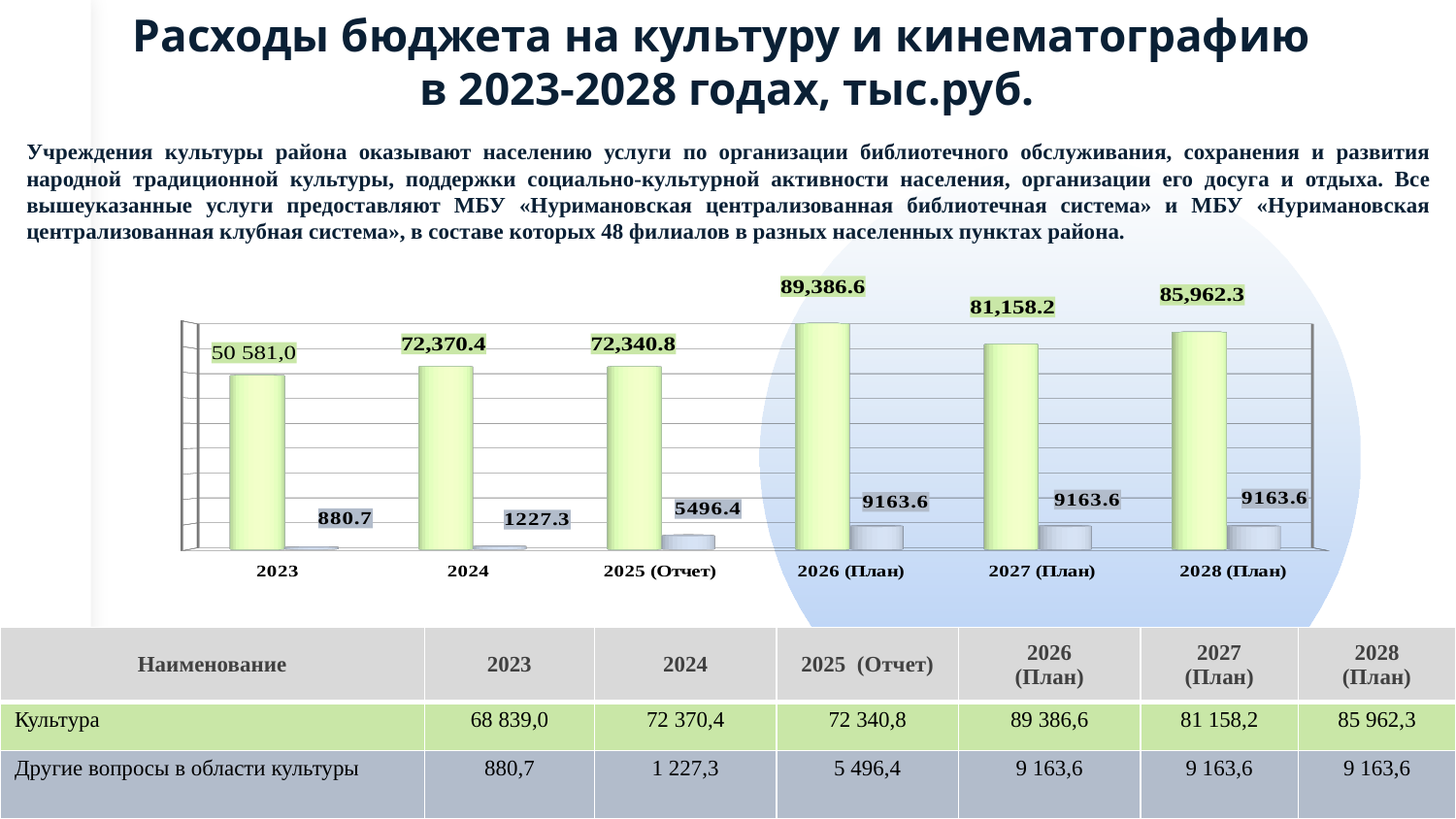
What unit of measurement is stated in the slide title for the chart values? тыс.руб. In which year is the small grey bar the lowest? 2023 Do the grey bar values rise or fall from 2023 to 2026 (План)? rise Which green bar is larger, 2027 (План) or 2028 (План)? 2028 (План) How many year categories are shown along the x axis of the chart? 6 What is the value of the tall green bar for 2026 (План)? 89,386.6 What kind of chart is shown on the slide? bar chart What is the difference between the green bar values for 2026 (План) and 2027 (План)? 8,228.4 What is the value of the small grey bar for 2025 (Отчет)? 5496.4 What is the difference between the grey bar values for 2025 (Отчет) and 2024? 4269.1 What is the value of the small grey bar for 2028 (План)? 9163.6 In which year is the tall green bar the highest? 2026 (План)